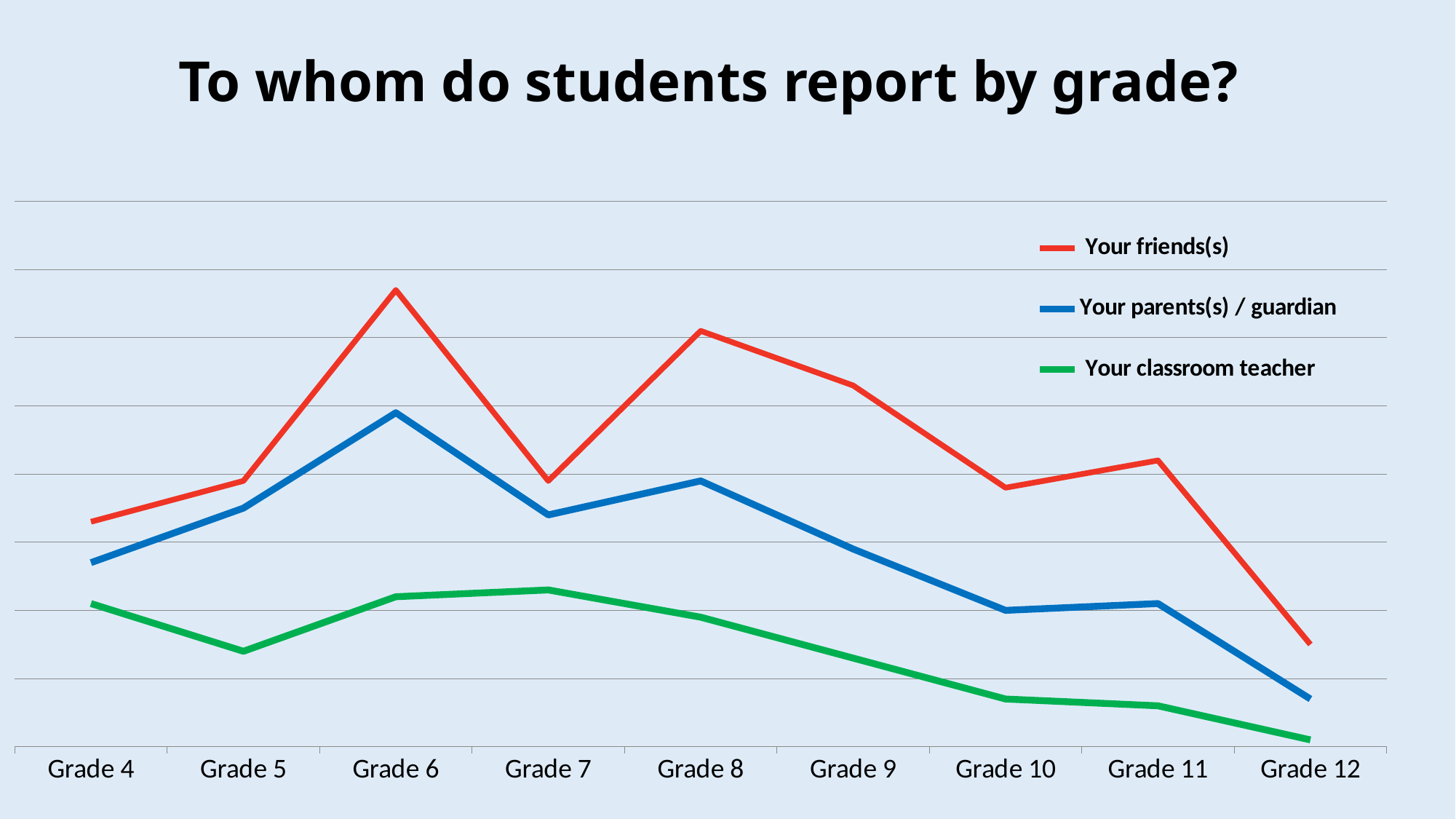
At which grade is the 'Your classroom teacher' line at its lowest? Grade 12 How many grades are shown along the x axis? 9 At which grade does the 'Your friends(s)' line reach its highest point? Grade 6 Does the 'Your classroom teacher' line rise or fall from Grade 7 to Grade 12? fall What is the title of the chart? To whom do students report by grade? At Grade 8, which is higher: 'Your friends(s)' or 'Your parents(s) / guardian'? Your friends(s) For 'Your friends(s)', which is higher: the value at Grade 6 or the value at Grade 8? Grade 6 At which grade does the 'Your parents(s) / guardian' line reach its highest point? Grade 6 What kind of chart is shown on the slide? line chart What colour is the 'Your classroom teacher' line? green At which grade is the 'Your friends(s)' line at its lowest? Grade 12 How many series does the legend list? 3